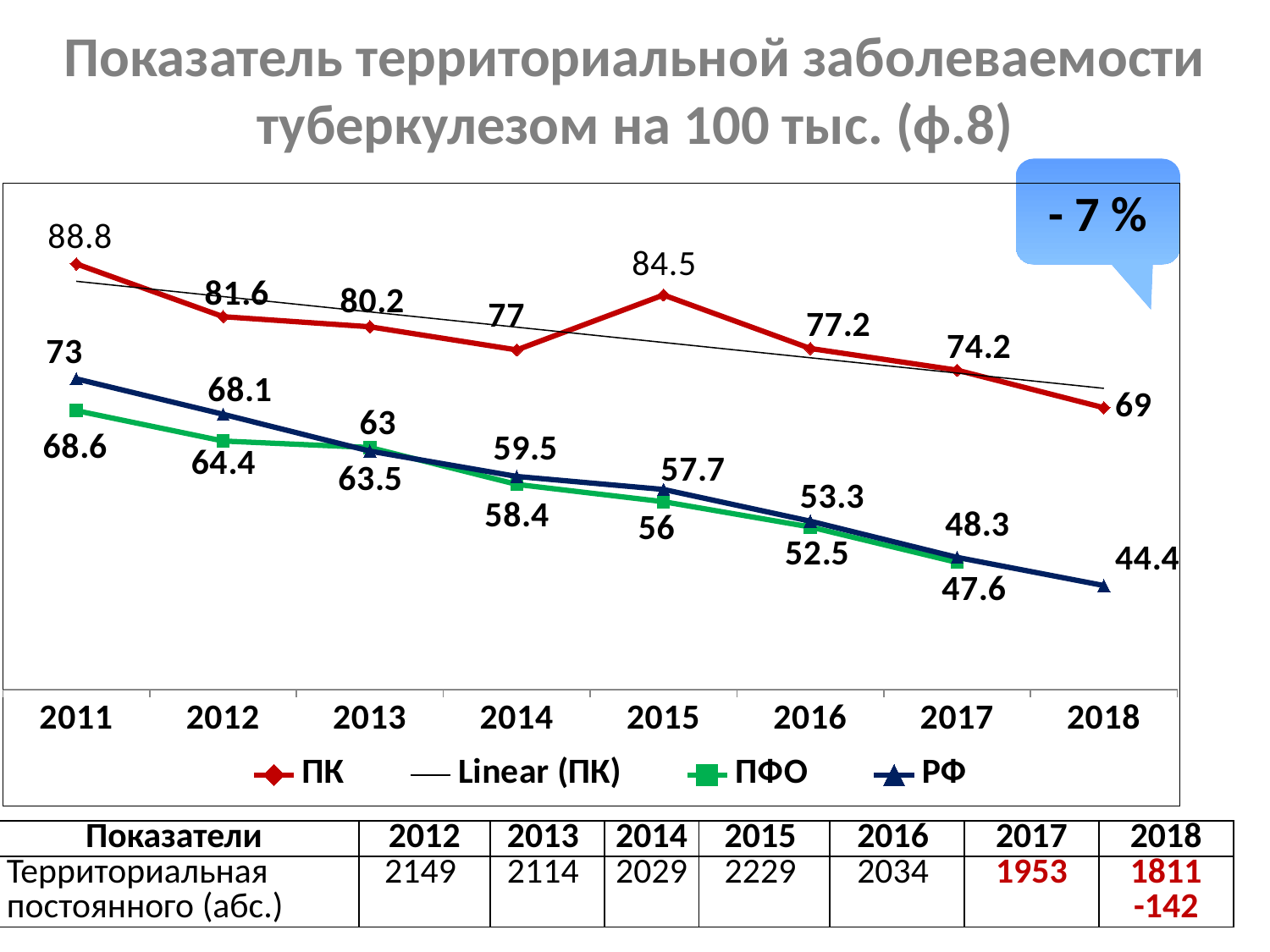
What is the value for РФ in 2018? 44.4 What is the difference between the ПК values in 2011 and 2018? 19.8 What kind of chart is shown? line chart What is the value for ПФО in 2017? 47.6 In which year is the ПК series at its lowest? 2018 How many entries does the legend list? 4 In which year is the РФ series at its highest? 2011 Which is larger in 2016, the value for ПК or the value for РФ? ПК What is the value for ПК in 2011? 88.8 Does the РФ series rise or fall from 2011 to 2018? fall How many years are shown on the x axis? 8 What is the value for ПК in 2015? 84.5